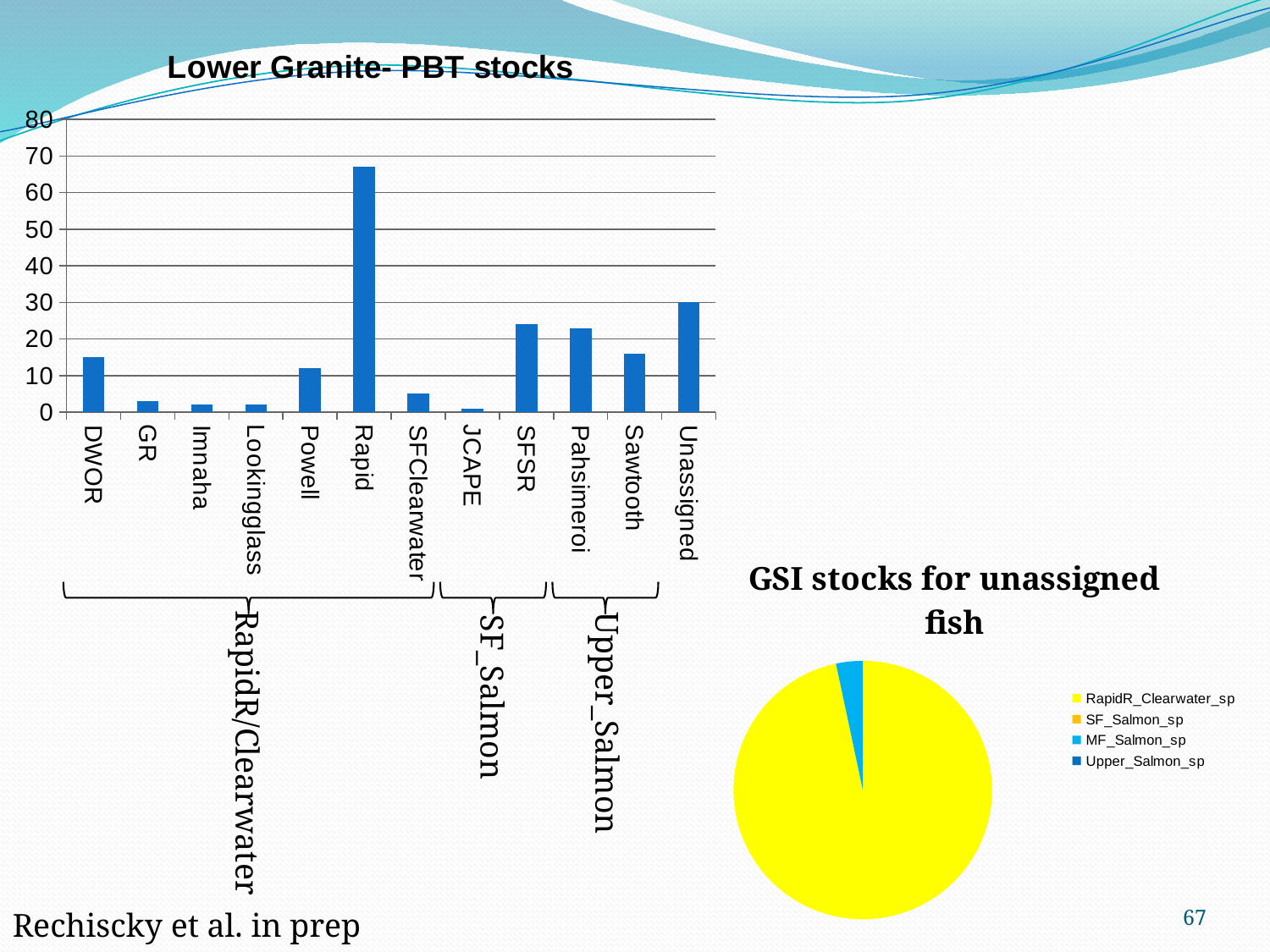
How many entries does the legend of the 'GSI stocks for unassigned fish' chart list? 4 What kind of chart is the 'Lower Granite- PBT stocks' chart? bar chart In the 'Lower Granite- PBT stocks' chart, which is larger, the value for Powell or the value for SFClearwater? Powell In the 'Lower Granite- PBT stocks' chart, how many categories are shown on the x axis? 12 In the 'Lower Granite- PBT stocks' chart, is the value for Sawtooth greater or less than 20? less In the 'Lower Granite- PBT stocks' chart, which category has the highest value? Rapid In the 'Lower Granite- PBT stocks' chart, is the value for Rapid greater or less than 60? greater In the 'Lower Granite- PBT stocks' chart, which is larger, the value for Unassigned or the value for Sawtooth? Unassigned In the 'Lower Granite- PBT stocks' chart, is the value for DWOR greater or less than 10? greater What kind of chart is the 'GSI stocks for unassigned fish' chart? pie chart In the 'Lower Granite- PBT stocks' chart, which category has the lowest value? JCAPE In the 'GSI stocks for unassigned fish' pie chart, which category has the largest slice? RapidR_Clearwater_sp